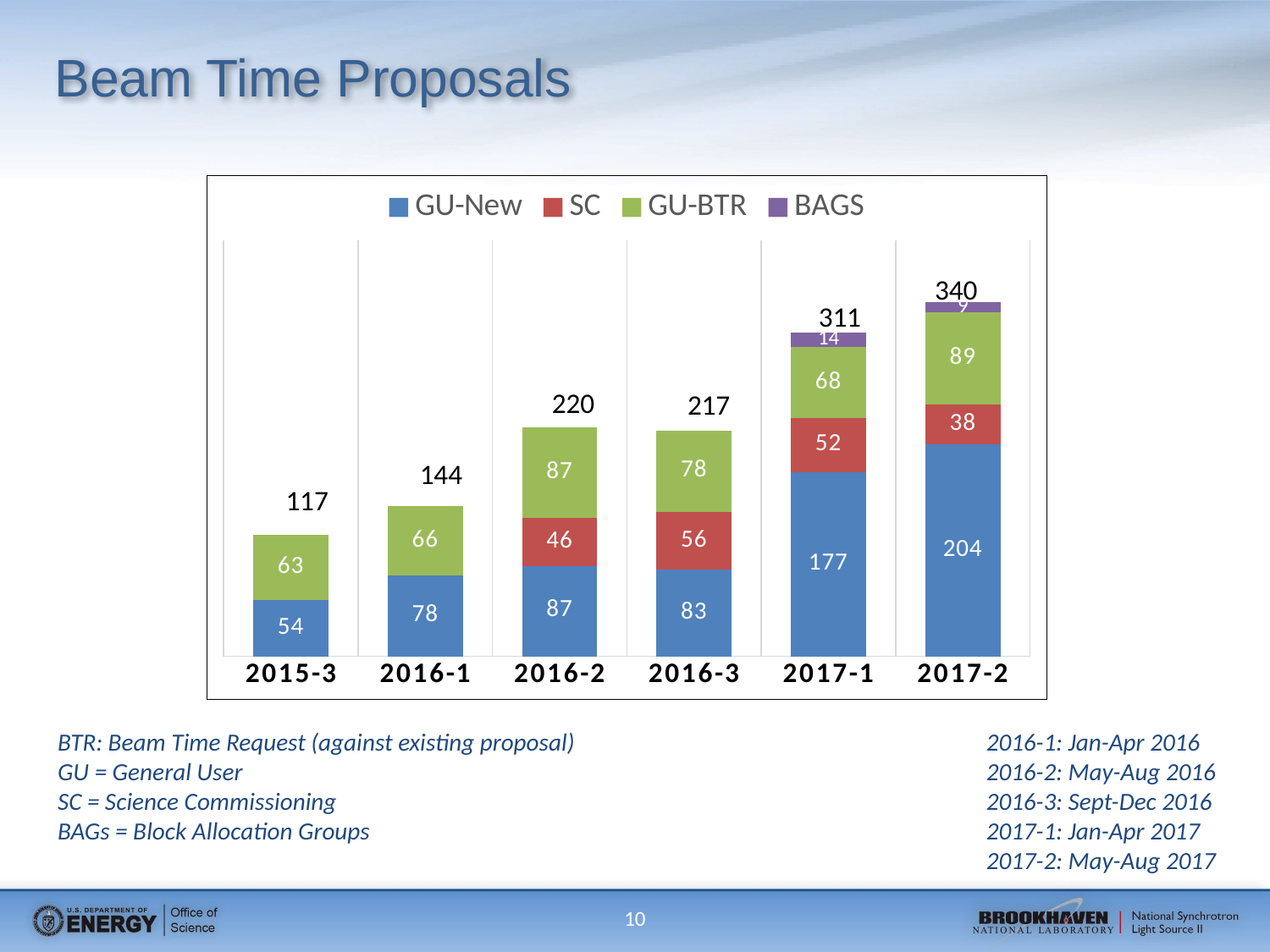
What is the GU-BTR value for 2015-3? 63 What is the difference between the total for 2017-1 and the total for 2016-3? 94 Which period has the highest total number of proposals? 2017-2 Which is larger, the GU-BTR value for 2016-2 or the GU-BTR value for 2017-1? 2016-2 What type of chart is shown on the slide? stacked bar chart How many periods (categories) are shown on the x axis? 6 What is the total number of beam time proposals for 2017-2? 340 What is the BAGS value for 2017-1? 14 What is the SC value for 2016-3? 56 What is the GU-New value for 2017-1? 177 Which period has the lowest total number of proposals? 2015-3 How many series does the legend list? 4